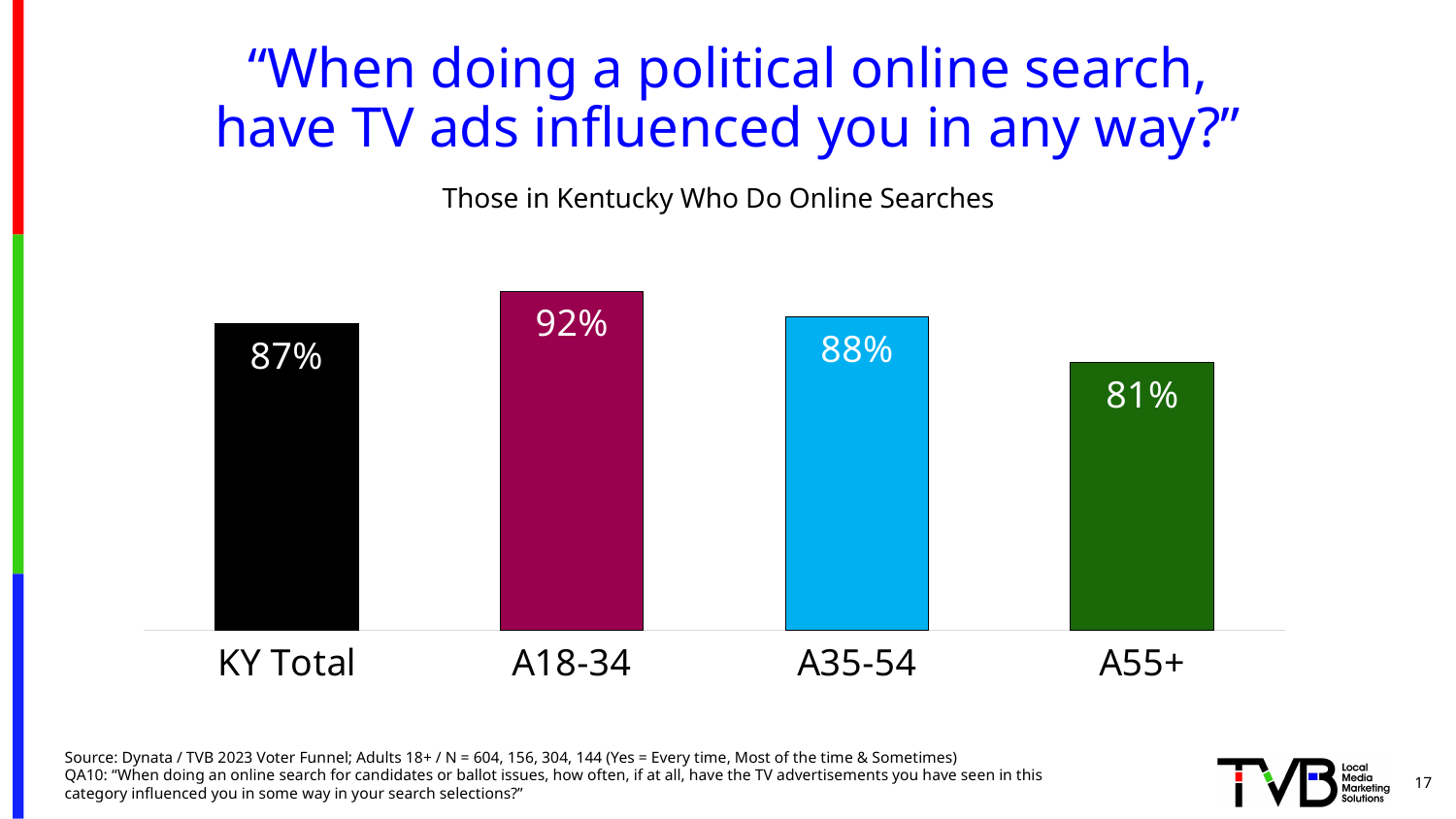
What kind of chart is shown on the slide? Bar chart What is the value for KY Total? 87% What is the value for A35-54? 88% What is the difference between the values for A35-54 and KY Total? 1% What is the subtitle shown above the chart? Those in Kentucky Who Do Online Searches Which category has the lowest value? A55+ How many categories are shown in the chart? 4 Which category has the highest value? A18-34 What is the value for A18-34? 92% What is the difference between the values for A18-34 and A55+? 11% What is the value for A55+? 81% Which is larger, the value for A18-34 or the value for A35-54? A18-34